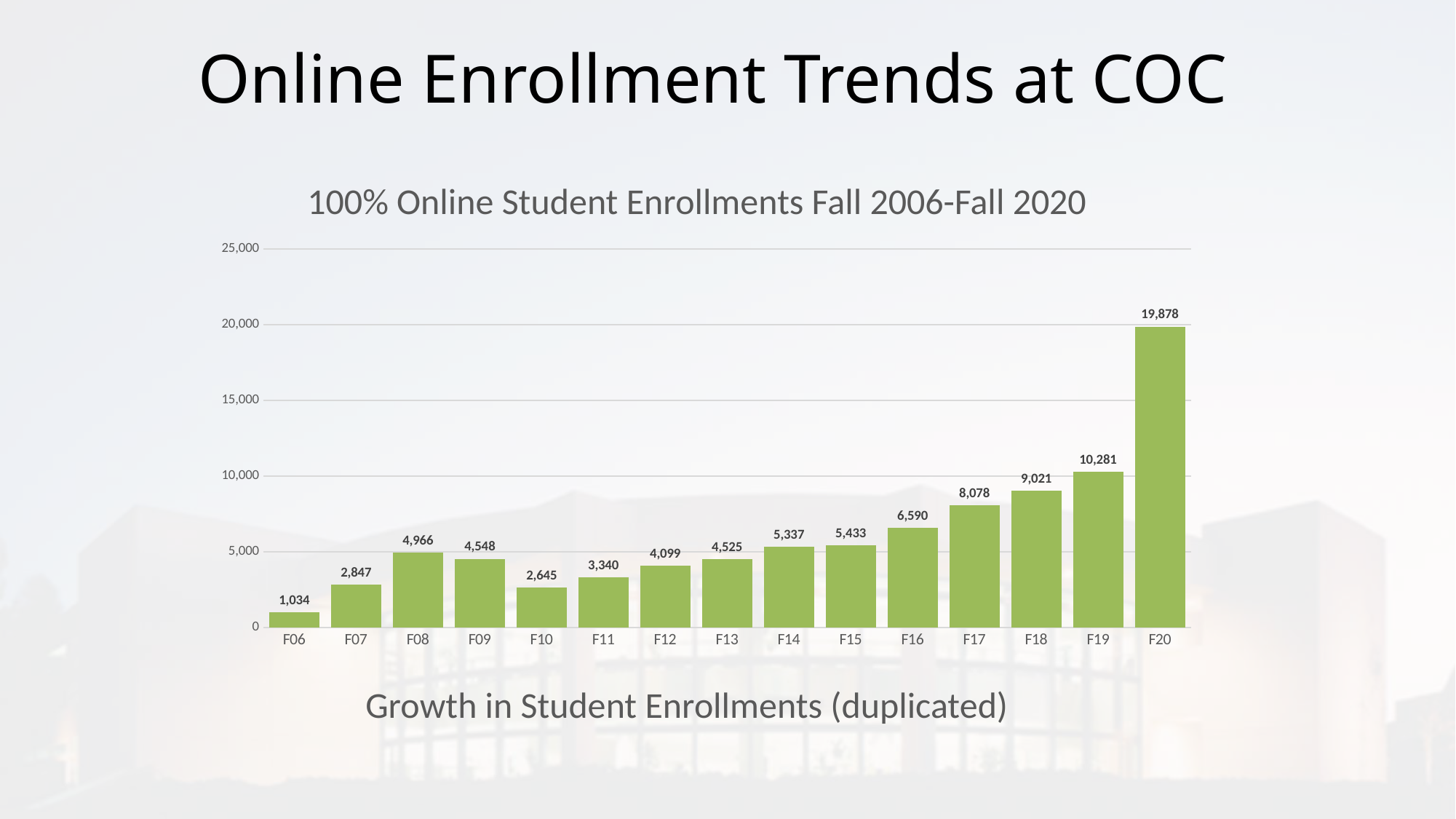
What is the title of the chart? 100% Online Student Enrollments Fall 2006-Fall 2020 What is the value for F13? 4,525 How many categories are shown on the x axis? 15 What is the difference between the values for F20 and F19? 9,597 What is the value for F20? 19,878 What kind of chart is this? bar chart Is the value for F18 greater or less than 10,000? less Which is larger, the value for F08 or the value for F09? F08 What is the value for F06? 1,034 Which category has the lowest value? F06 Which category has the highest value? F20 Do the values generally rise or fall from F10 to F20? rise